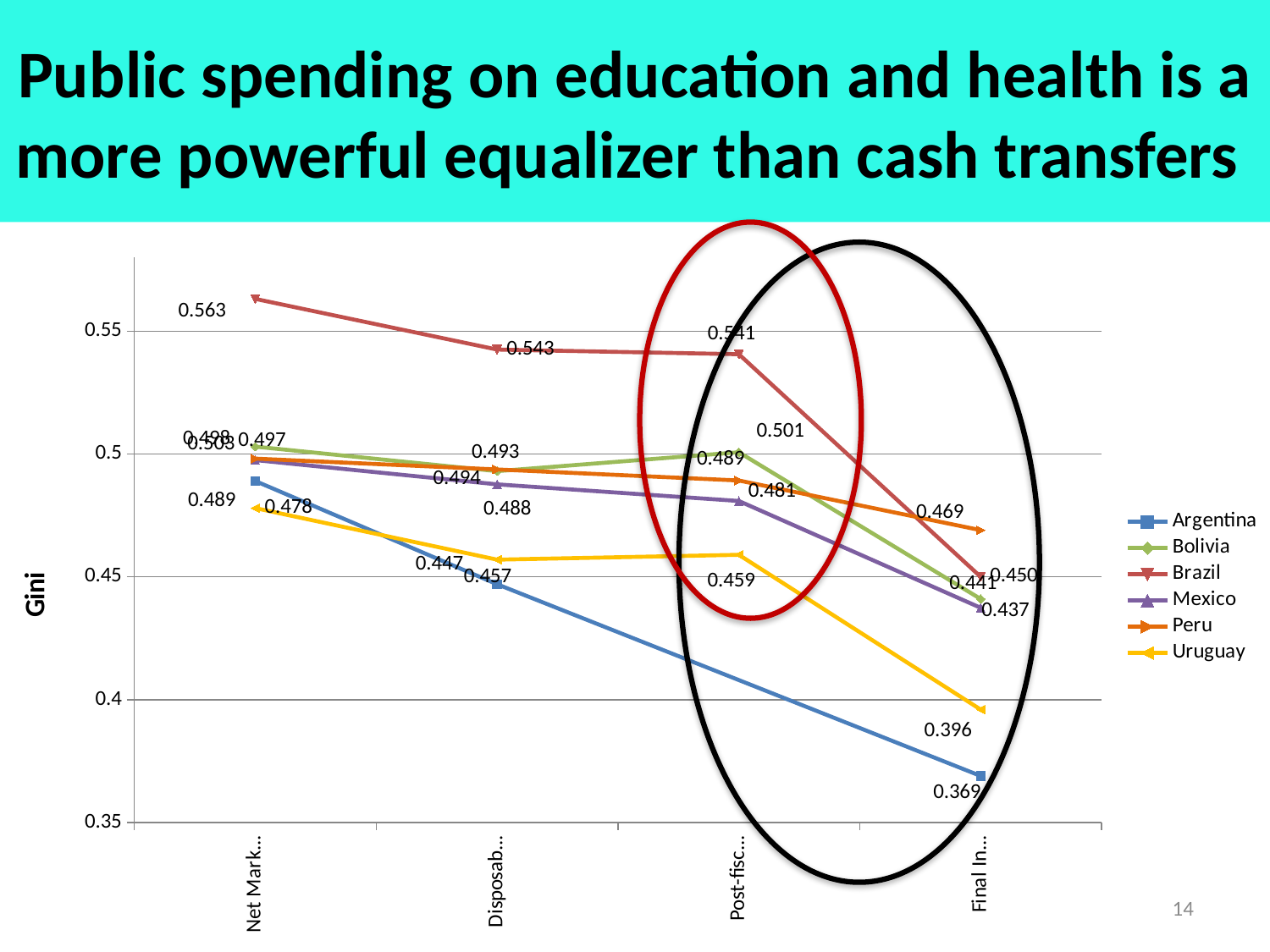
Which country has the lowest Gini value at the last category (Final In...)? Argentina What is the Gini value for Peru at the last category (Final In...)? 0.469 What is the difference between Brazil's Gini at Net Mark... (0.563) and at Final In... (0.450)? 0.113 What is the Gini value for Brazil at the first category (Net Mark...)? 0.563 At the last category (Final In...), which is larger: the Gini for Mexico or for Uruguay? Mexico What is the Gini value for Argentina at the last category (Final In...)? 0.369 What type of chart is shown on the slide? line chart Which country has the highest Gini value at the last category (Final In...)? Peru Does the Gini value for Argentina rise or fall from the first category to the last? fall How many categories are shown along the x axis? 4 How many series does the legend list? 6